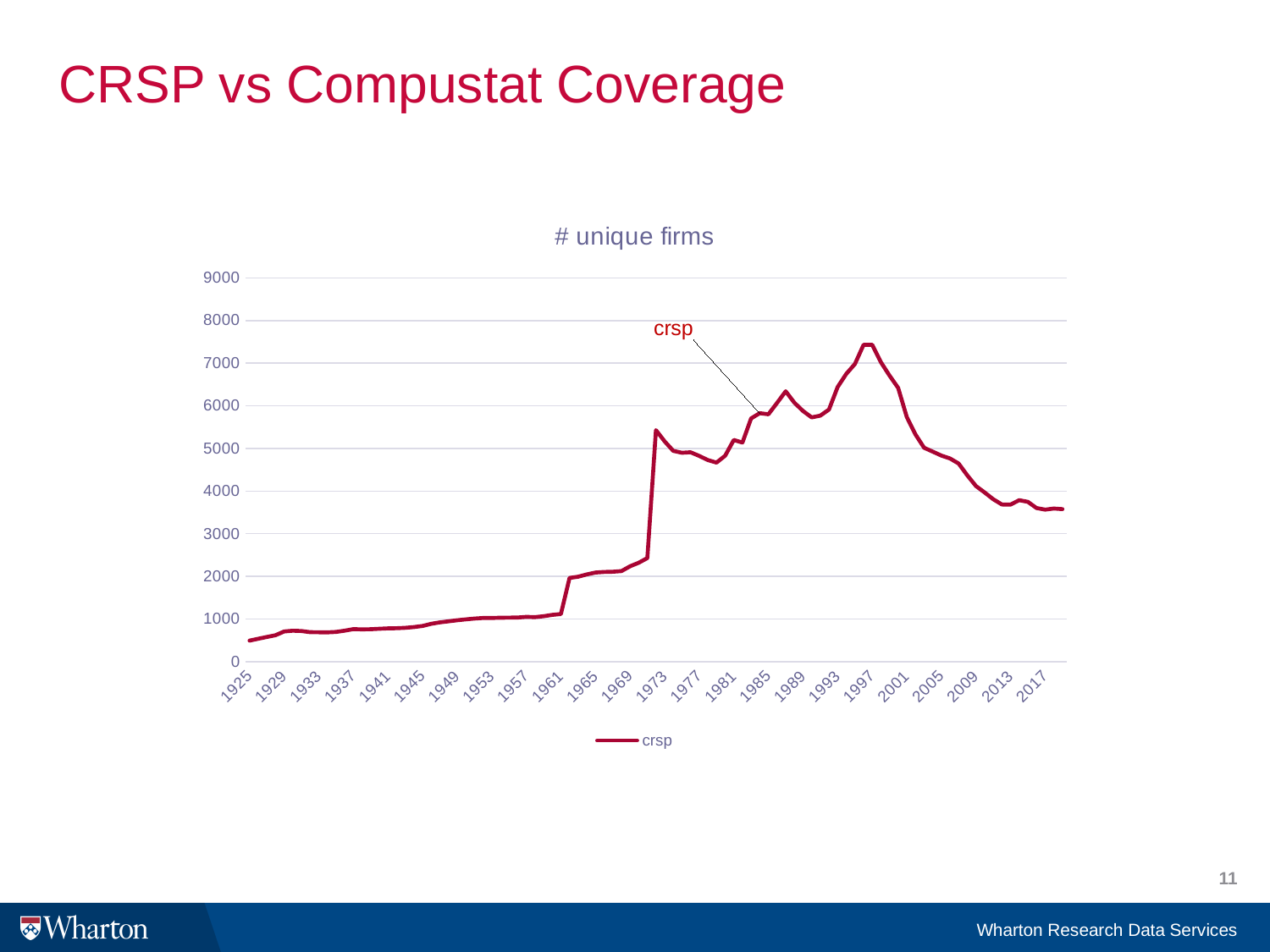
Is the value for 2017 greater or less than 3000? greater Is the value for 1945 greater or less than 1000? less In which year does the crsp line reach its highest value? 1997 Is the value for 1925 greater or less than 1000? less What is the title of the chart? # unique firms Which year has the larger value, 1997 or 2017? 1997 How many series does the legend list? 1 What kind of chart is shown on the slide? line chart What is the name of the series shown in the legend? crsp Does the crsp line rise or fall between 1997 and 2017? fall